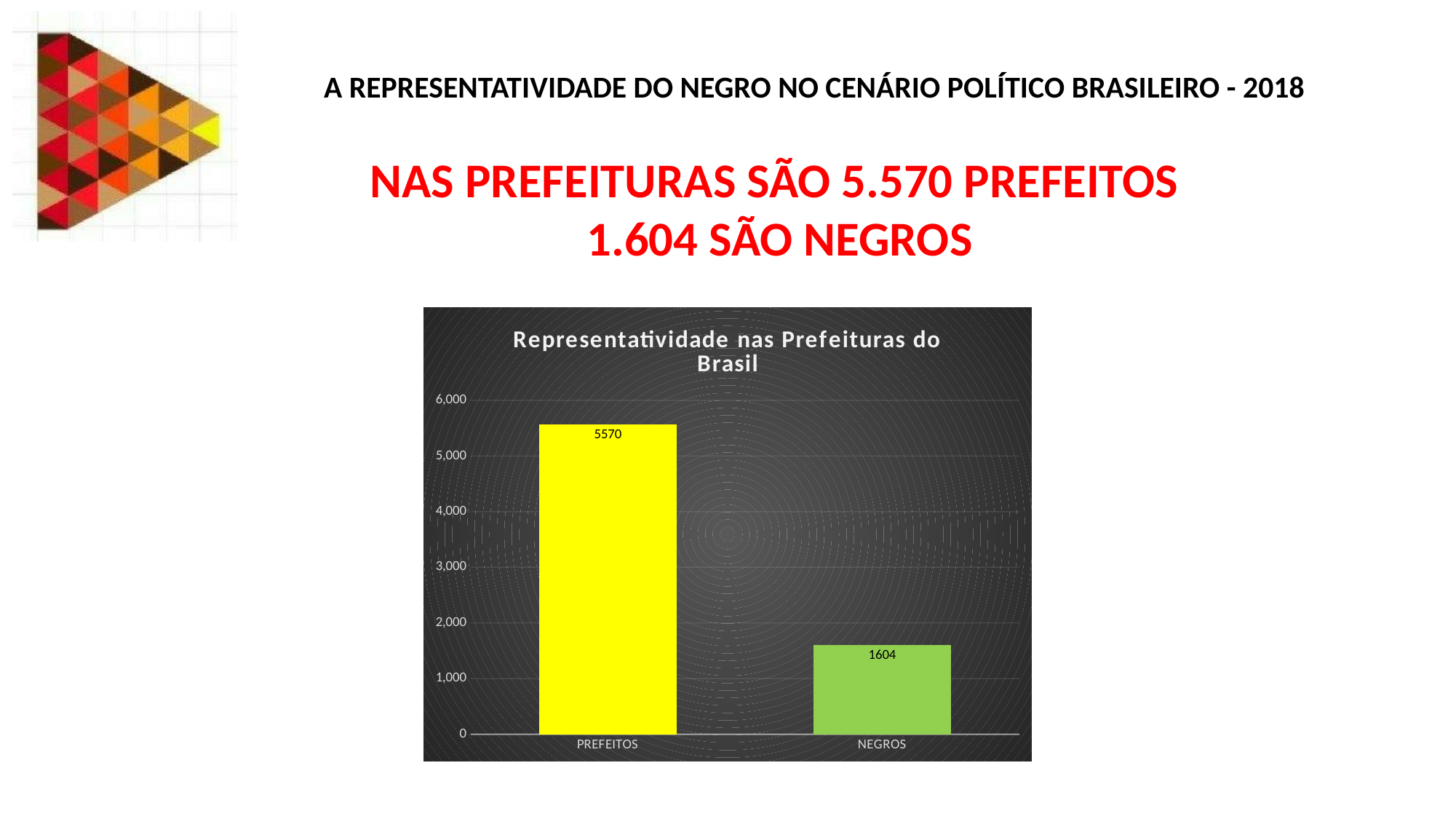
What colour is the bar for NEGROS? green How many categories are shown on the x axis? 2 What is the difference between the values for PREFEITOS and NEGROS? 3966 What is the title of the chart? Representatividade nas Prefeituras do Brasil What kind of chart is shown on the slide? bar chart What is the value for NEGROS? 1604 Which category has the lowest value? NEGROS Is the value for NEGROS greater or less than 2,000? less What is the value for PREFEITOS? 5570 Is the value for PREFEITOS greater or less than 5,000? greater Which is larger, the value for PREFEITOS or the value for NEGROS? PREFEITOS Which category has the highest value? PREFEITOS